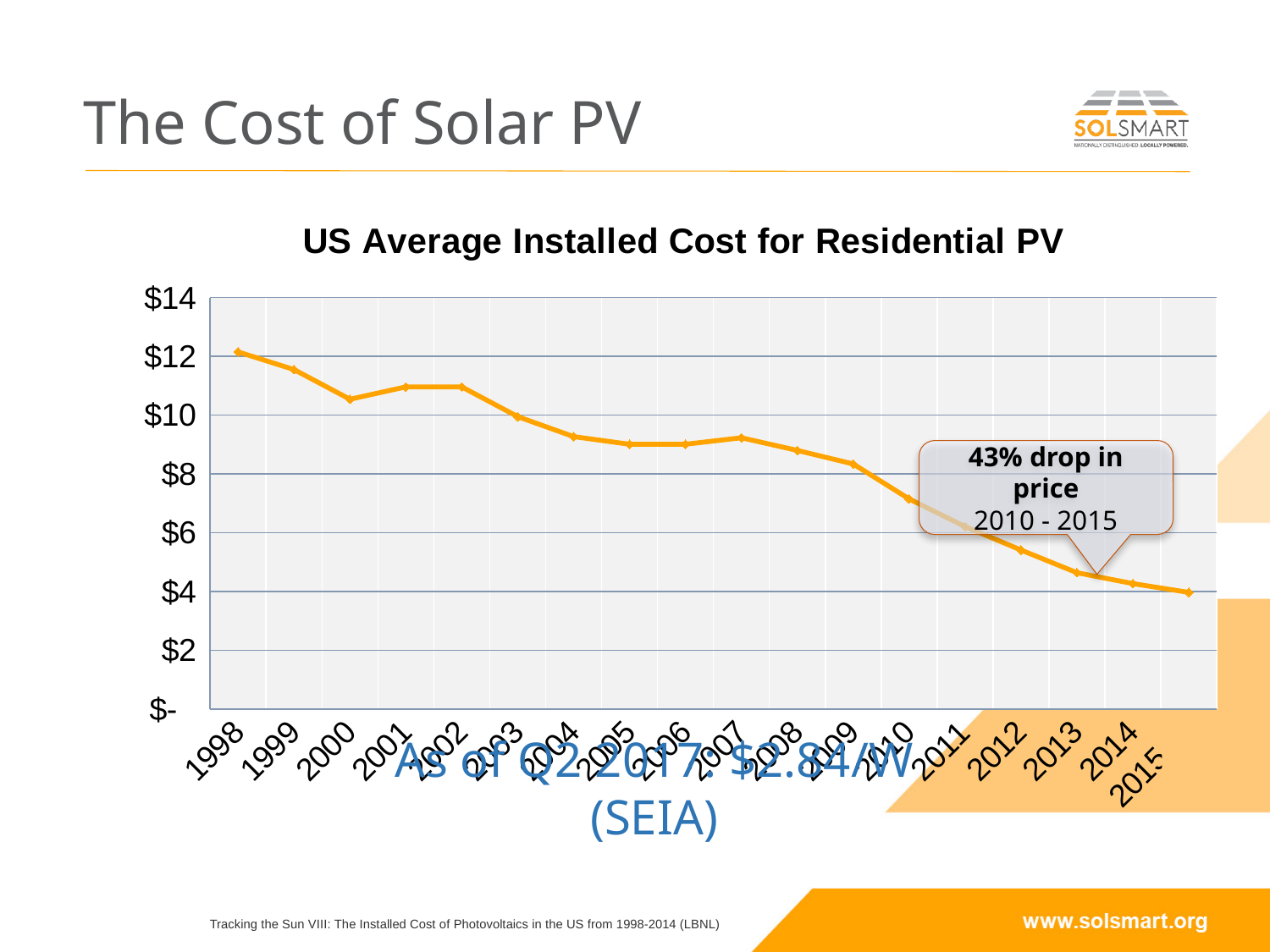
Which year has the larger value, 2000 or 2010? 2000 Is the value for 2005 greater or less than $8? greater What is the title of the chart? US Average Installed Cost for Residential PV Which year has the lowest average installed cost in the chart? 2015 Which year has the highest average installed cost in the chart? 1998 What kind of chart is shown on the slide? line chart According to the callout on the chart, what percentage drop in price occurred from 2010 to 2015? 43% Do the values in the chart generally rise or fall from 1998 to 2015? fall Is the value for 2015 greater or less than $6? less How many years are plotted along the x axis of the chart? 18 Is the value for 2012 greater or less than $6? less